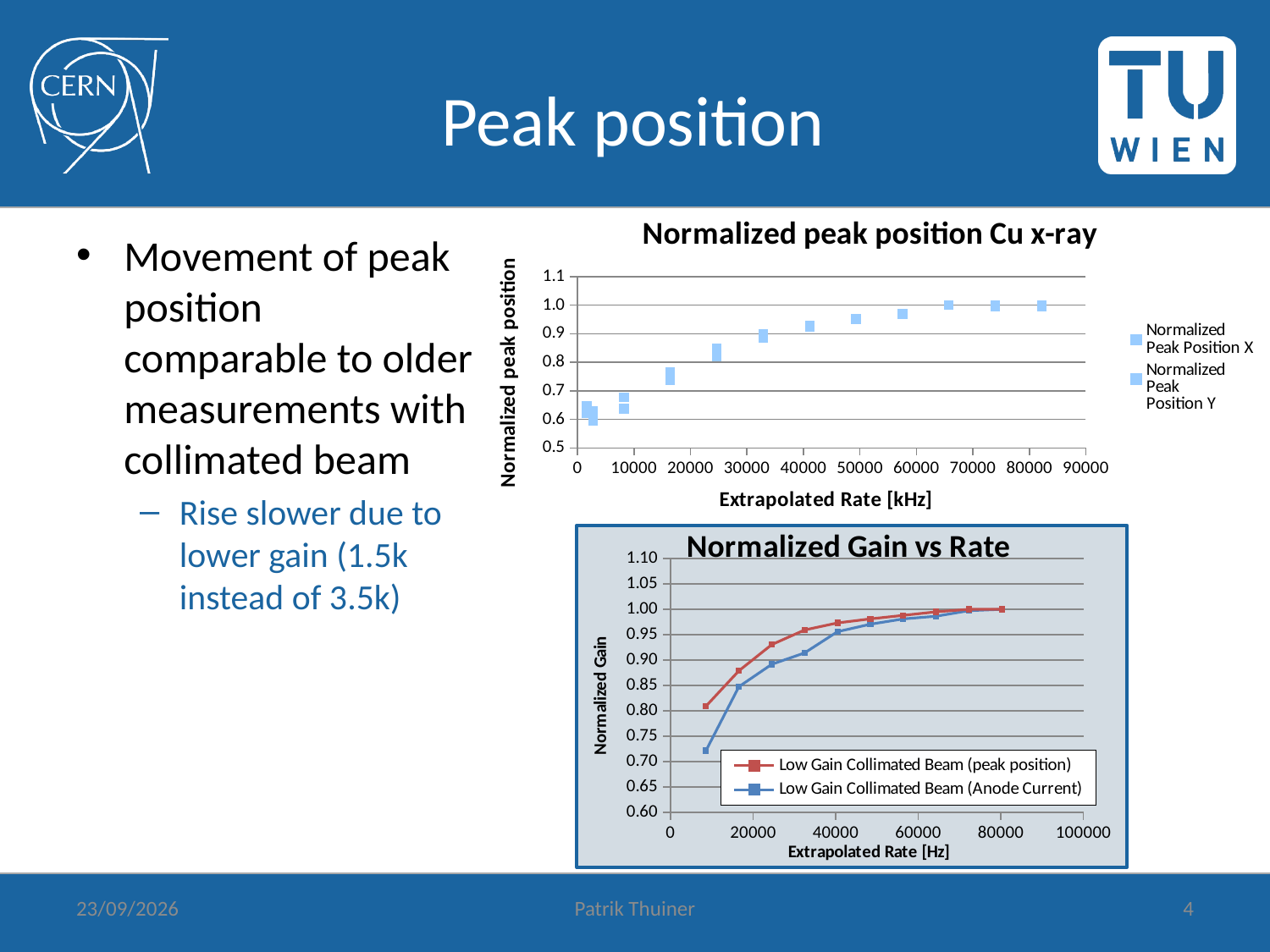
What kind of chart is the 'Normalized peak position Cu x-ray' chart? scatter chart In the 'Normalized Gain vs Rate' chart, at the lowest rate plotted, which series has the higher normalized gain: 'Low Gain Collimated Beam (peak position)' or 'Low Gain Collimated Beam (Anode Current)'? Low Gain Collimated Beam (peak position) What is the x-axis label of the 'Normalized Gain vs Rate' chart? Extrapolated Rate [Hz] In the 'Normalized Gain vs Rate' chart, is the first point of the 'Low Gain Collimated Beam (Anode Current)' series greater or less than 0.80? less What kind of chart is the 'Normalized Gain vs Rate' chart? line chart How many series does the legend of the 'Normalized peak position Cu x-ray' chart list? 2 How many series does the legend of the 'Normalized Gain vs Rate' chart list? 2 What is the y-axis label of the 'Normalized peak position Cu x-ray' chart? Normalized peak position In the 'Normalized Gain vs Rate' chart, do the values rise or fall as the extrapolated rate increases? rise In the 'Normalized peak position Cu x-ray' chart, is the normalized peak position at the highest rate (around 82000) greater or less than 0.9? greater In the 'Normalized peak position Cu x-ray' chart, are the normalized peak position values at rates below 5000 greater or less than 0.7? less In the 'Normalized peak position Cu x-ray' chart, do the values rise or fall as the extrapolated rate increases? rise